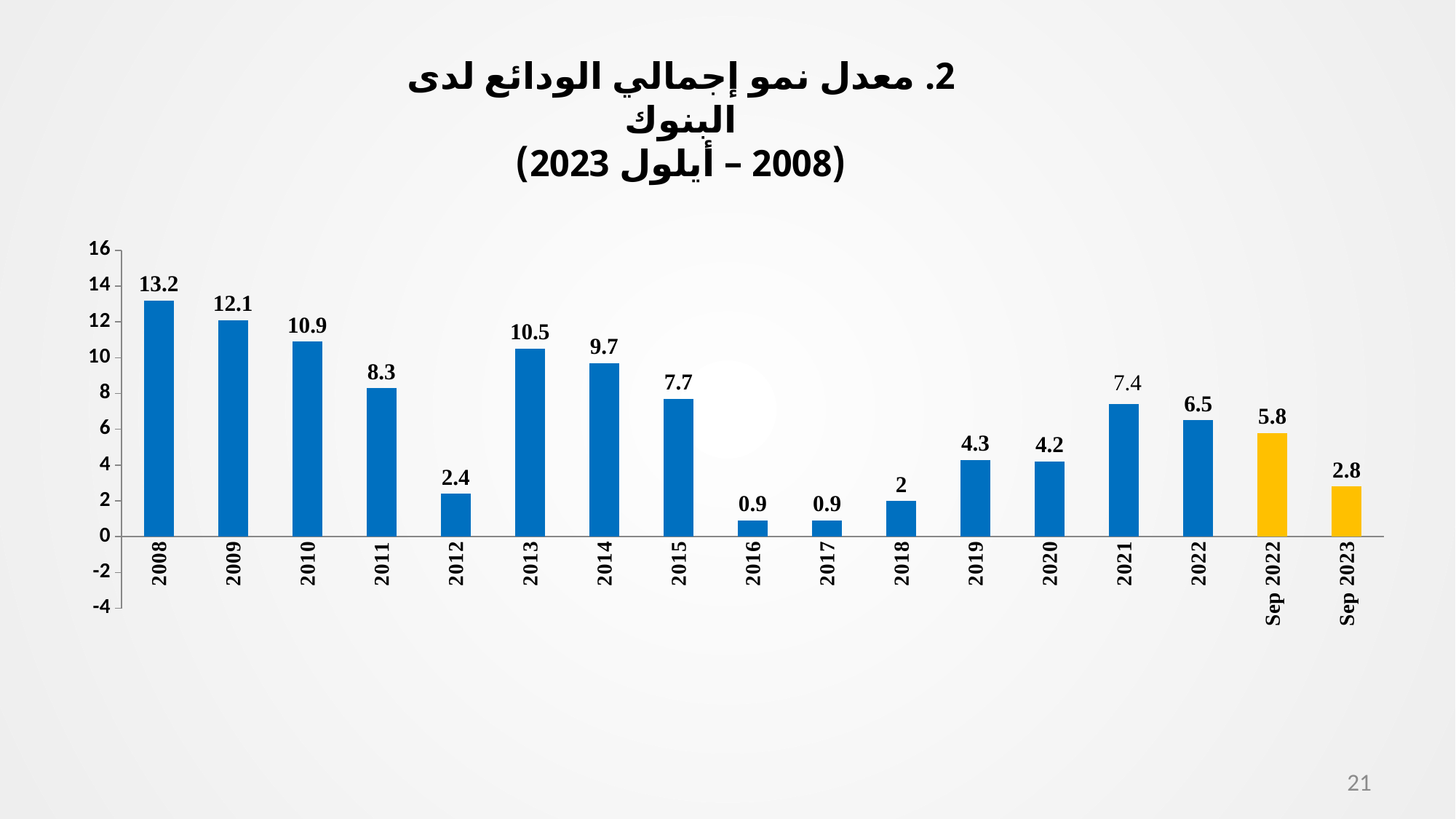
What is the value for Sep 2023? 2.8 What is the value for 2013? 10.5 What is the difference between the values for Sep 2022 and Sep 2023? 3 Is the value for 2011 greater or less than 8? greater Which is larger, the value for 2014 or the value for 2015? 2014 What is the lowest value shown on the chart? 0.9 Which bars are coloured yellow instead of blue? Sep 2022 and Sep 2023 What is the difference between the values for 2021 and 2022? 0.9 How many bars are shown on the chart? 17 What kind of chart is this? bar chart What is the value for 2008? 13.2 Which year has the highest value? 2008